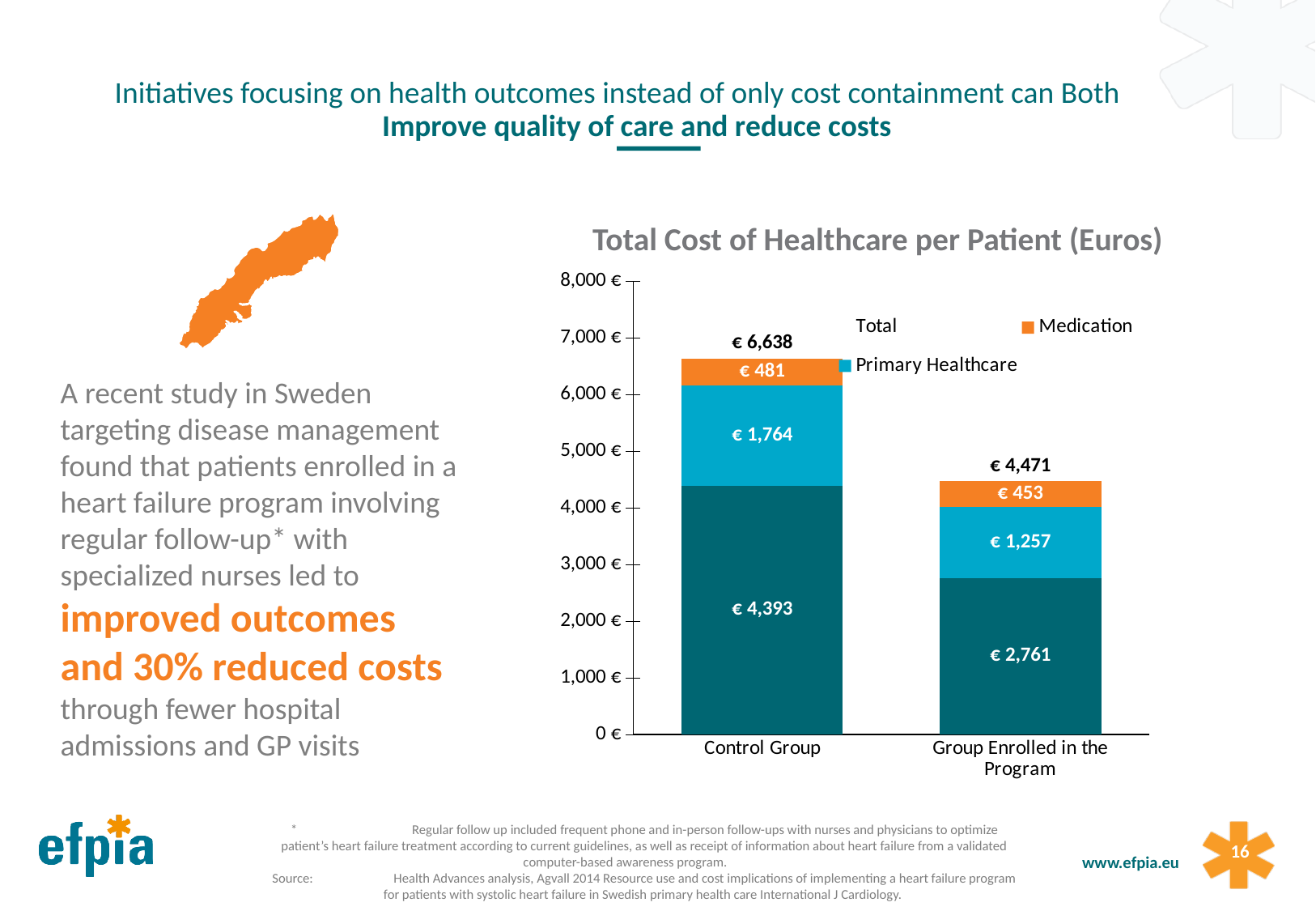
What is the total cost of healthcare per patient for the Control Group? € 6,638 What is the Medication cost for the Control Group? € 481 What is the Primary Healthcare cost for the Group Enrolled in the Program? € 1,257 What is the difference between the total cost for the Control Group and the total cost for the Group Enrolled in the Program? € 2,167 What kind of chart is used to show the total cost of healthcare per patient? Stacked bar chart Which group has the higher Medication cost, the Control Group or the Group Enrolled in the Program? Control Group How much higher is the Primary Healthcare cost for the Control Group than for the Group Enrolled in the Program? € 507 How many groups are shown on the x axis of the chart? 2 What is the title of the chart? Total Cost of Healthcare per Patient (Euros) What is the value of the bottom dark teal segment of the Group Enrolled in the Program bar? € 2,761 What is the total cost of healthcare per patient for the Group Enrolled in the Program? € 4,471 How many entries does the chart legend list? 3